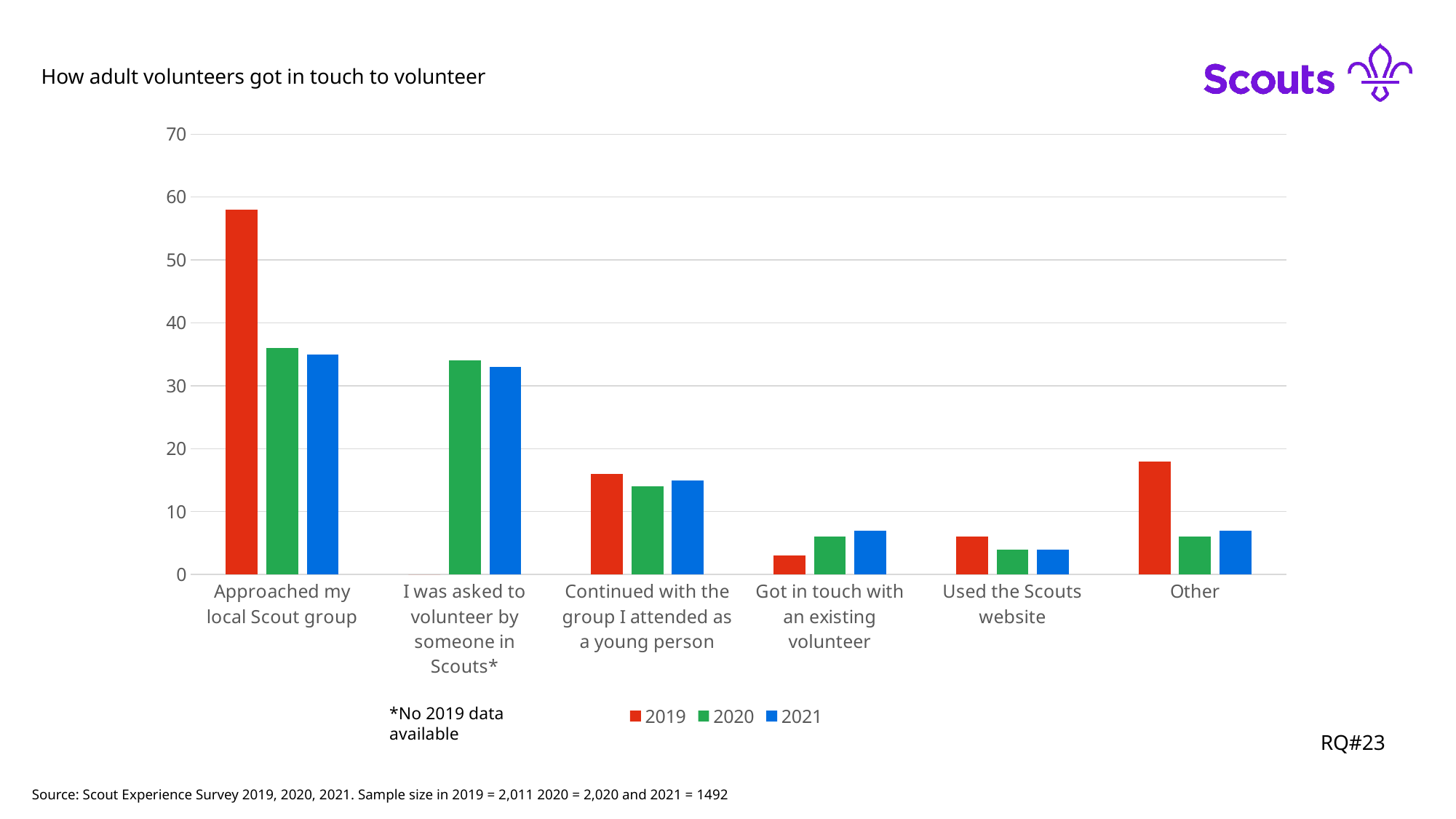
Is the 2019 value for 'Other' greater or less than 20? less Which series has no data for 'I was asked to volunteer by someone in Scouts*'? 2019 What is the title of the chart? How adult volunteers got in touch to volunteer Is the 2020 value for 'Used the Scouts website' greater or less than 10? less How many categories are shown on the x axis? 6 Which category has the lowest 2019 bar? Got in touch with an existing volunteer How many series does the legend list? 3 Which is larger for 'Approached my local Scout group': the 2019 value or the 2021 value? 2019 What kind of chart is shown on the slide? Bar chart Which category has the highest bar in the chart? Approached my local Scout group Is the 2020 value for 'Approached my local Scout group' greater or less than 30? greater